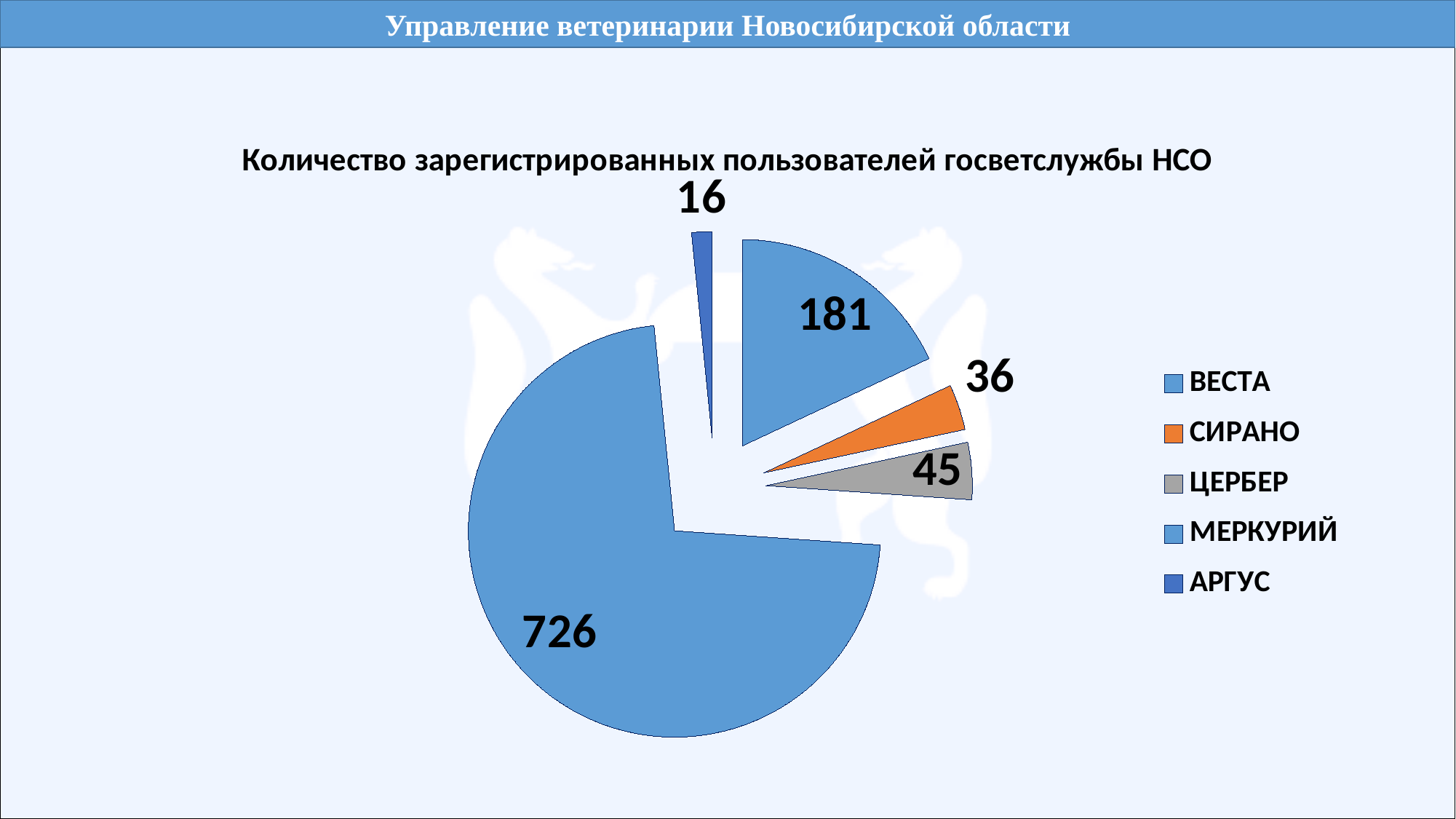
What is the value for ВЕСТА in the pie chart? 181 What is the value for АРГУС in the pie chart? 16 What is the value for МЕРКУРИЙ in the pie chart? 726 What is the difference between the values for МЕРКУРИЙ and ВЕСТА? 545 What kind of chart is shown on the slide? Pie chart Which is larger, the value for ЦЕРБЕР or the value for СИРАНО? ЦЕРБЕР How many categories does the pie chart show? 5 What is the title of the chart? Количество зарегистрированных пользователей госветслужбы НСО Which category has the largest slice in the pie chart? МЕРКУРИЙ Which category has the smallest slice in the pie chart? АРГУС What is the value for СИРАНО in the pie chart? 36 What is the value for ЦЕРБЕР in the pie chart? 45